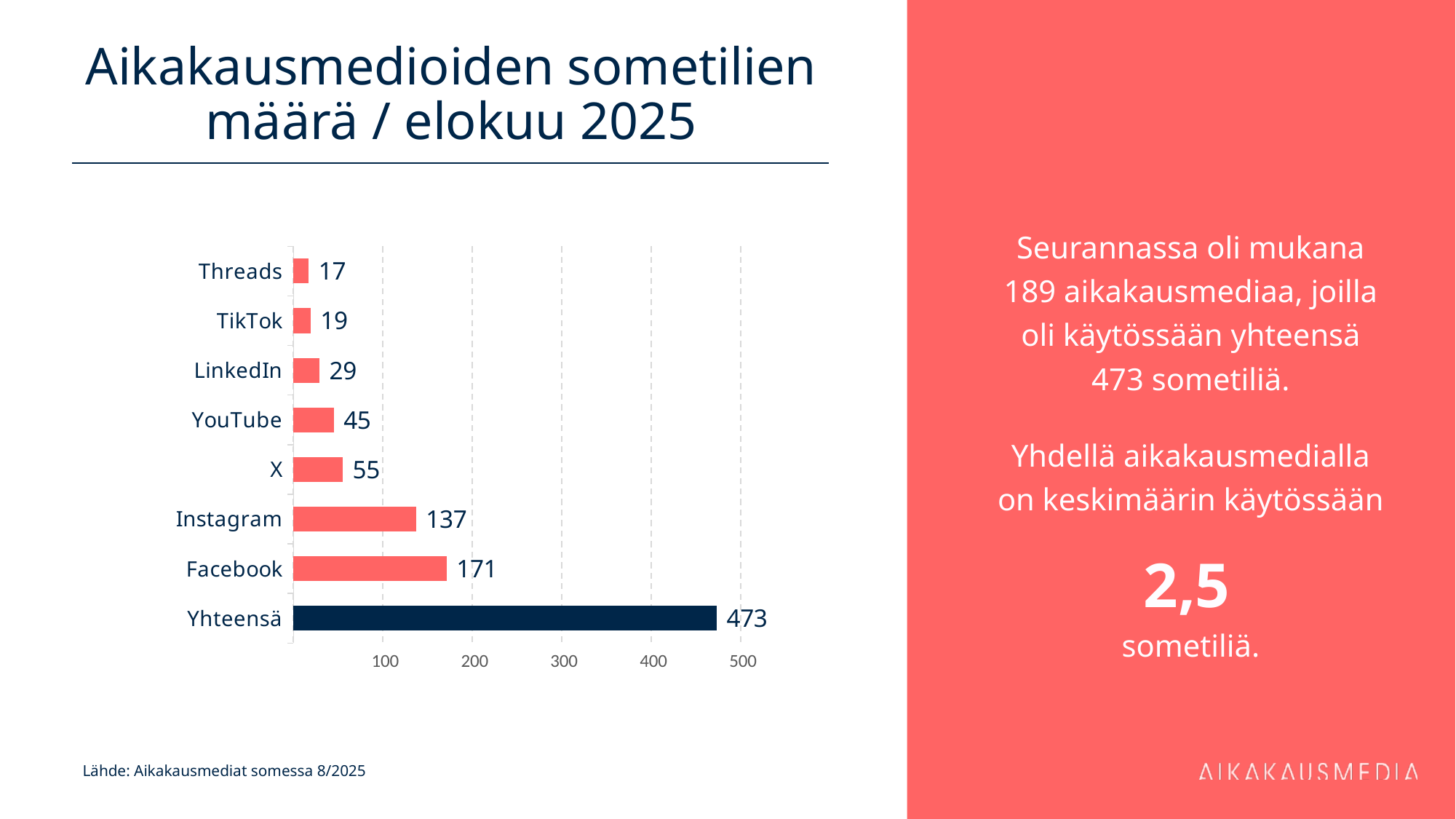
Is the value for Instagram greater or less than 100? greater Which platform has the lowest value? Threads What is the value shown for Yhteensä? 473 What is the value for LinkedIn? 29 What kind of chart is shown on the slide? Bar chart What is the difference between the values for Facebook and Instagram? 34 How many bars are shown in the chart? 8 What is the value for Facebook? 171 What is the value for Instagram? 137 Excluding the Yhteensä total bar, which platform has the highest value? Facebook Which bar is shown in a different (dark navy) colour from the others? Yhteensä Which has a larger value, X or YouTube? X